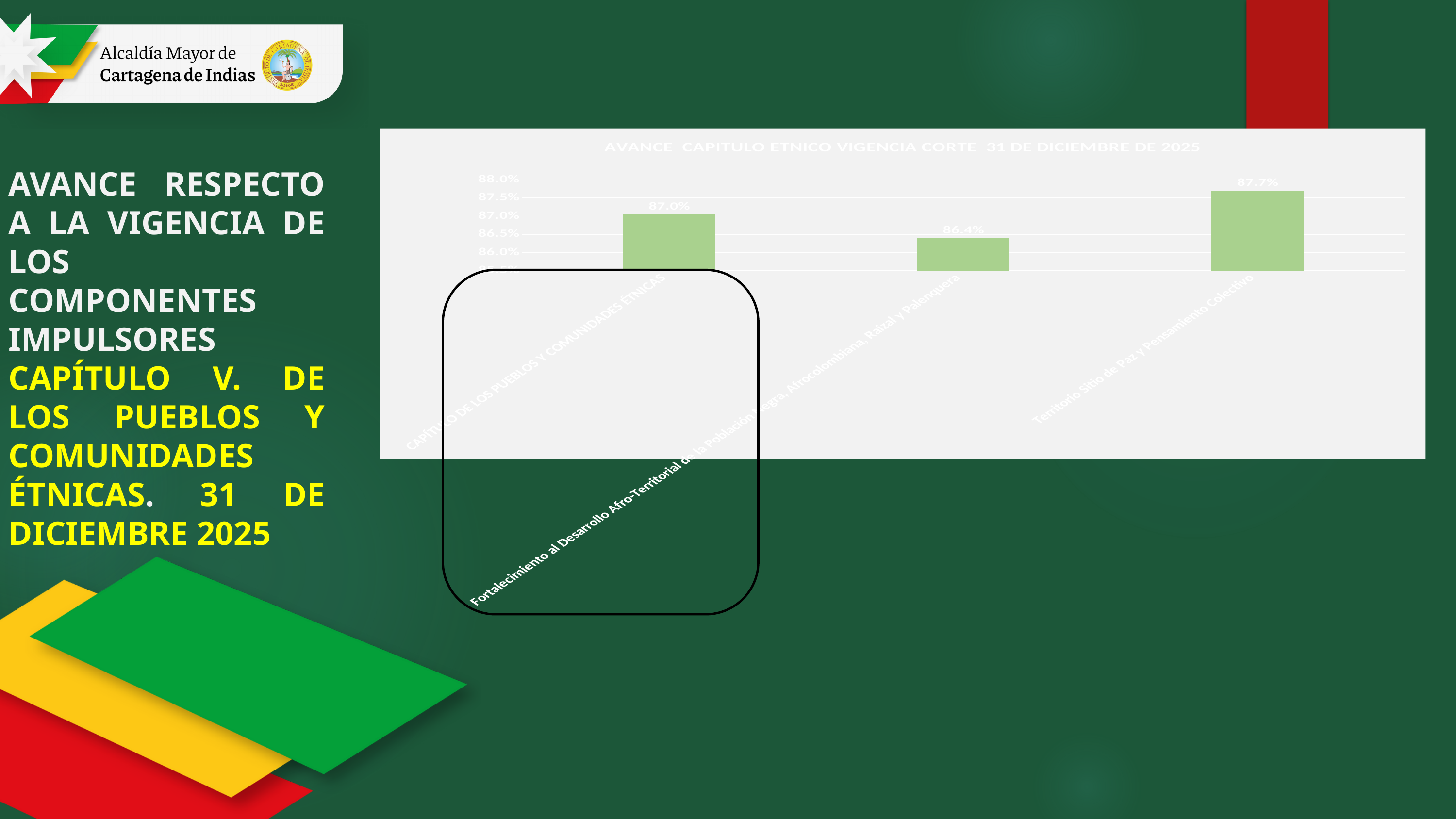
What is the difference between the values for Territorio Sitio de Paz y Pensamiento Colectivo and CAPÍTULO DE LOS PUEBLOS Y COMUNIDADES ÉTNICAS? 0.7% What is the title of the chart? AVANCE CAPITULO ETNICO VIGENCIA CORTE 31 DE DICIEMBRE DE 2025 What is the value for Fortalecimiento al Desarrollo Afro-Territorial de la Población Negra, Afrocolombiana, Raizal y Palenquera? 86.4% Is the value for Fortalecimiento al Desarrollo Afro-Territorial greater or less than 87.0%? less How many categories are shown in the chart? 3 What is the difference between the values for CAPÍTULO DE LOS PUEBLOS Y COMUNIDADES ÉTNICAS and Fortalecimiento al Desarrollo Afro-Territorial? 0.6% What kind of chart is shown on the slide? Bar chart What is the value for Territorio Sitio de Paz y Pensamiento Colectivo? 87.7% Which category has the lowest value? Fortalecimiento al Desarrollo Afro-Territorial de la Población Negra, Afrocolombiana, Raizal y Palenquera Which is larger: the value for Territorio Sitio de Paz y Pensamiento Colectivo or the value for Fortalecimiento al Desarrollo Afro-Territorial? Territorio Sitio de Paz y Pensamiento Colectivo What is the value for CAPÍTULO DE LOS PUEBLOS Y COMUNIDADES ÉTNICAS? 87.0% Which category has the highest value? Territorio Sitio de Paz y Pensamiento Colectivo